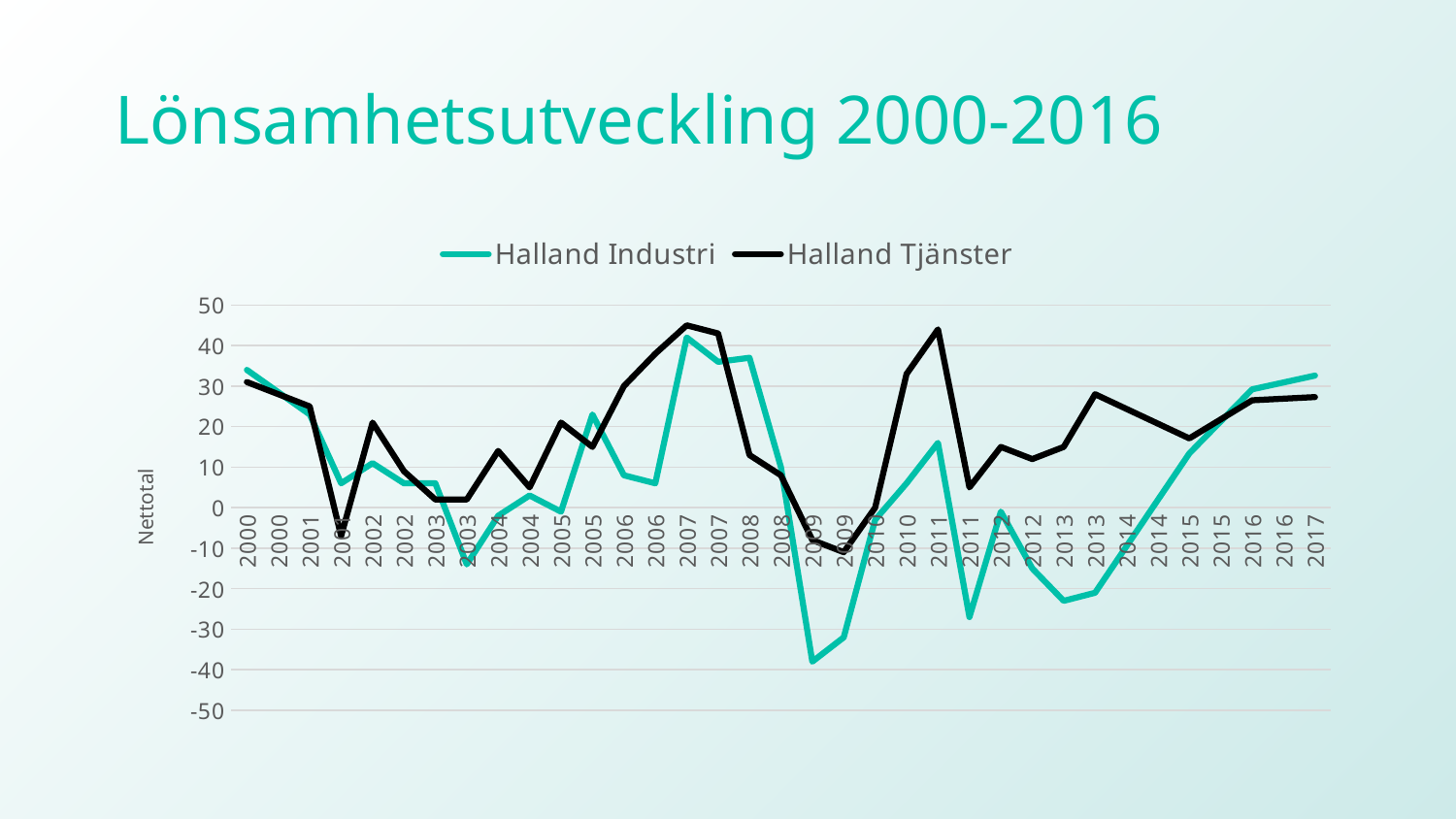
What is the title of the chart? Lönsamhetsutveckling 2000-2016 What is the label on the vertical axis? Nettotal Which series reaches the lowest value on the chart? Halland Industri How many series does the legend list? 2 In which year does Halland Industri reach its highest value? 2007 What kind of chart is shown on the slide? Line chart Is the first value for Halland Tjänster in 2000 greater or less than 20? greater Is the peak value for Halland Tjänster in 2011 greater or less than 40? greater In which year does Halland Industri reach its lowest value? 2009 Is the lowest value for Halland Industri in 2009 greater or less than -30? less At the first point of 2008, which series has the higher value, Halland Industri or Halland Tjänster? Halland Industri At the first point of 2013, which series has the higher value, Halland Industri or Halland Tjänster? Halland Tjänster